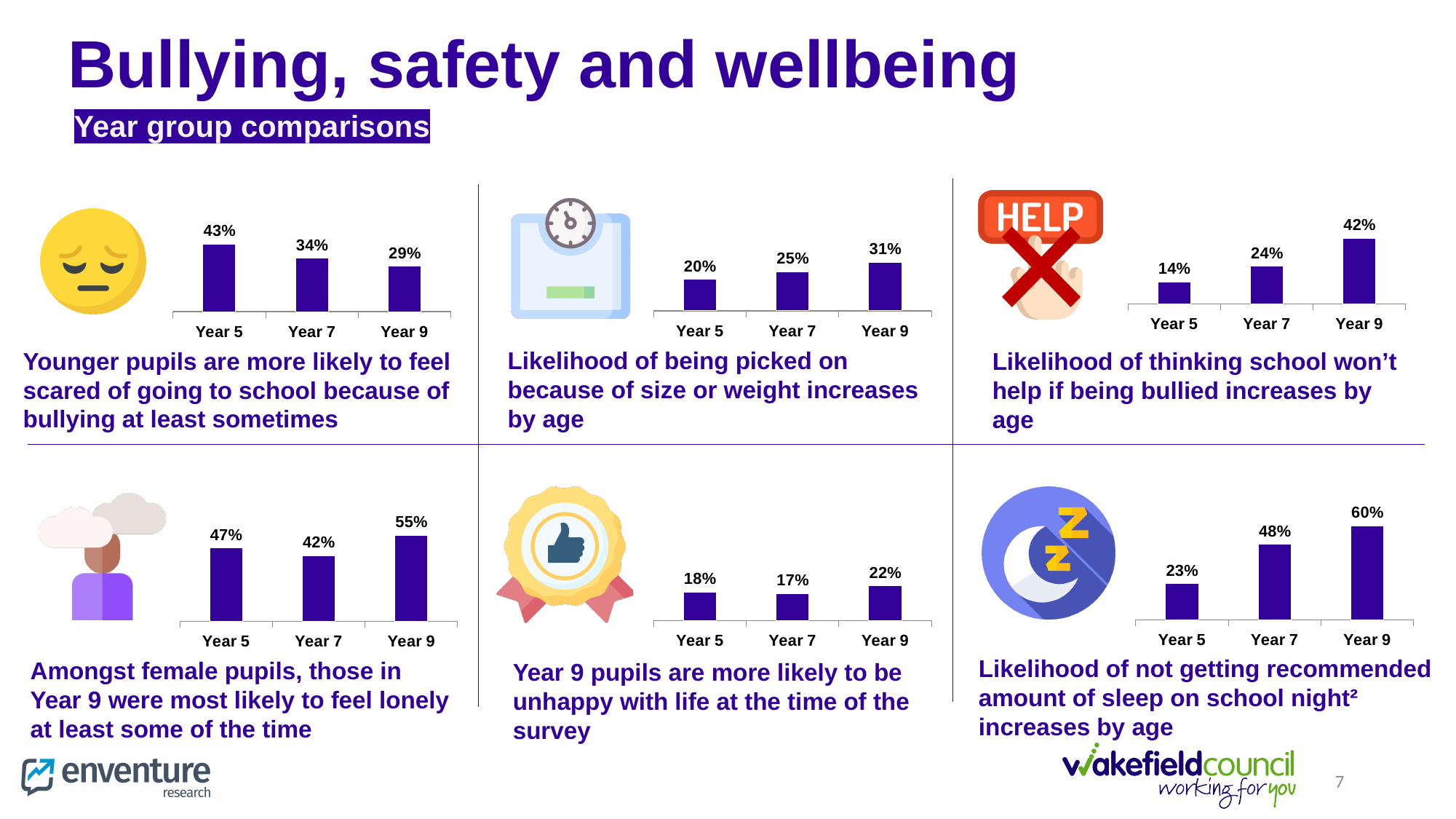
In the top-middle chart (picked on because of size or weight), what is the value for Year 7? 25% In the bottom-right chart (not getting recommended amount of sleep), what is the difference between Year 9 and Year 7? 12% In the bottom-middle chart (unhappy with life), what is the value for Year 9? 22% In the top-middle chart (picked on because of size or weight), do the values rise or fall from Year 5 to Year 9? rise In the top-left chart (scared of going to school because of bullying), which year group has the lowest value? Year 9 How many year groups are shown in the bottom-right chart (not getting recommended amount of sleep)? 3 In the top-right chart (thinking school won't help if being bullied), which year group has the highest value? Year 9 In the bottom-left chart (female pupils feeling lonely), which is larger, Year 5 or Year 9? Year 9 What kind of chart is the top-left chart (scared of going to school because of bullying)? bar chart In the bottom-left chart (female pupils feeling lonely), what is the value for Year 7? 42% In the top-right chart (thinking school won't help if being bullied), what is the difference between Year 9 and Year 5? 28% In the top-left chart (scared of going to school because of bullying), what is the value for Year 5? 43%